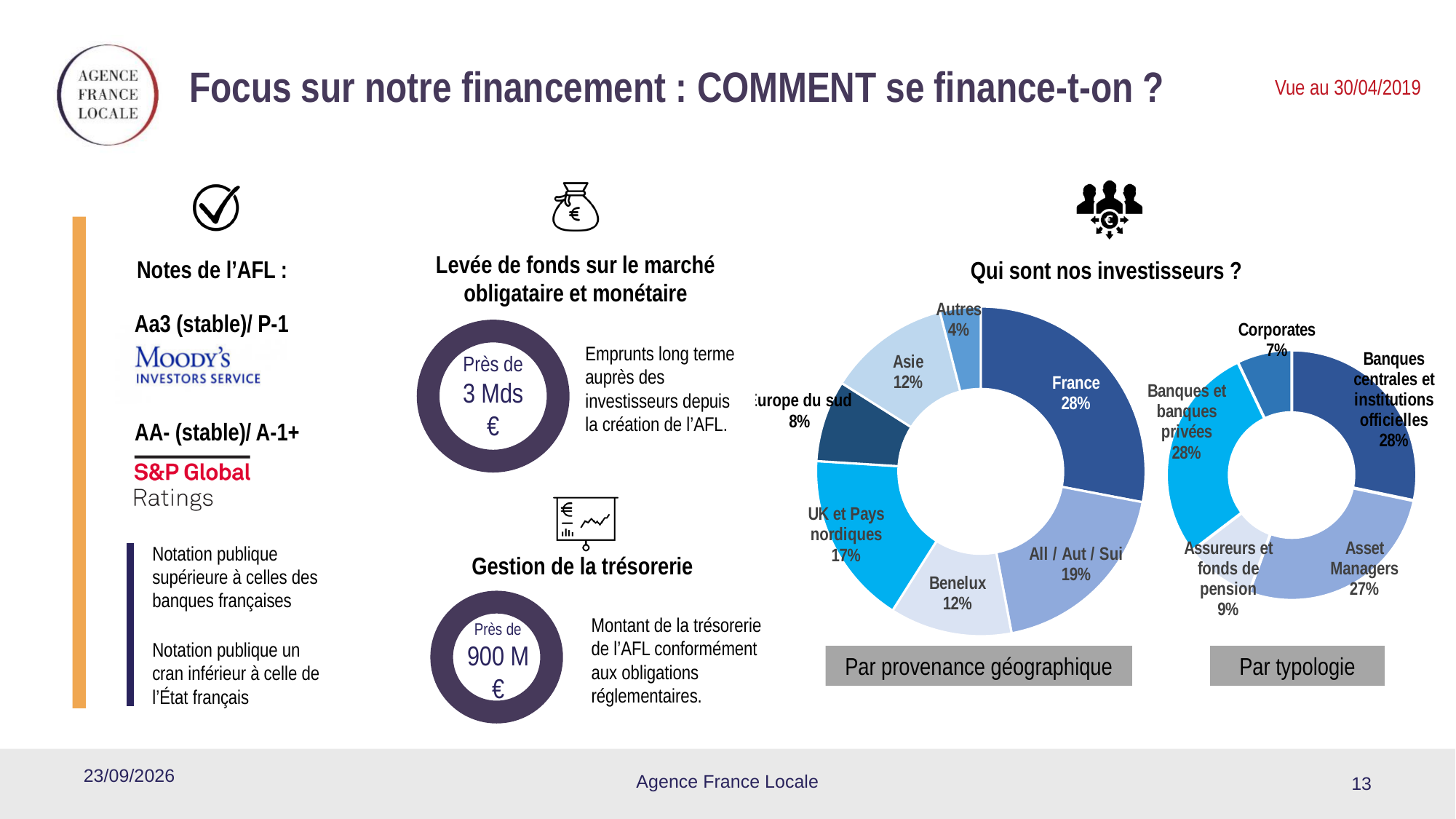
In the 'Par provenance géographique' chart, what is the difference in percentage points between France and All / Aut / Sui? 9 In the 'Par provenance géographique' chart, what is the share for UK et Pays nordiques? 17% In the 'Par provenance géographique' chart, which region has the largest share? France In the 'Par typologie' chart, which category has the smallest share? Corporates In the 'Par provenance géographique' chart, what share of investors comes from France? 28% In the 'Par typologie' chart, how many categories are shown? 5 In the 'Par typologie' chart, what is the share for Corporates? 7% In the 'Par provenance géographique' chart, how many categories are shown? 7 In the 'Par provenance géographique' chart, which is larger: Benelux or Europe du sud? Benelux In the 'Par provenance géographique' chart, which category has the smallest share? Autres What type of chart is used for 'Par typologie'? Donut (pie) chart In the 'Par typologie' chart, what share do Asset Managers represent? 27%